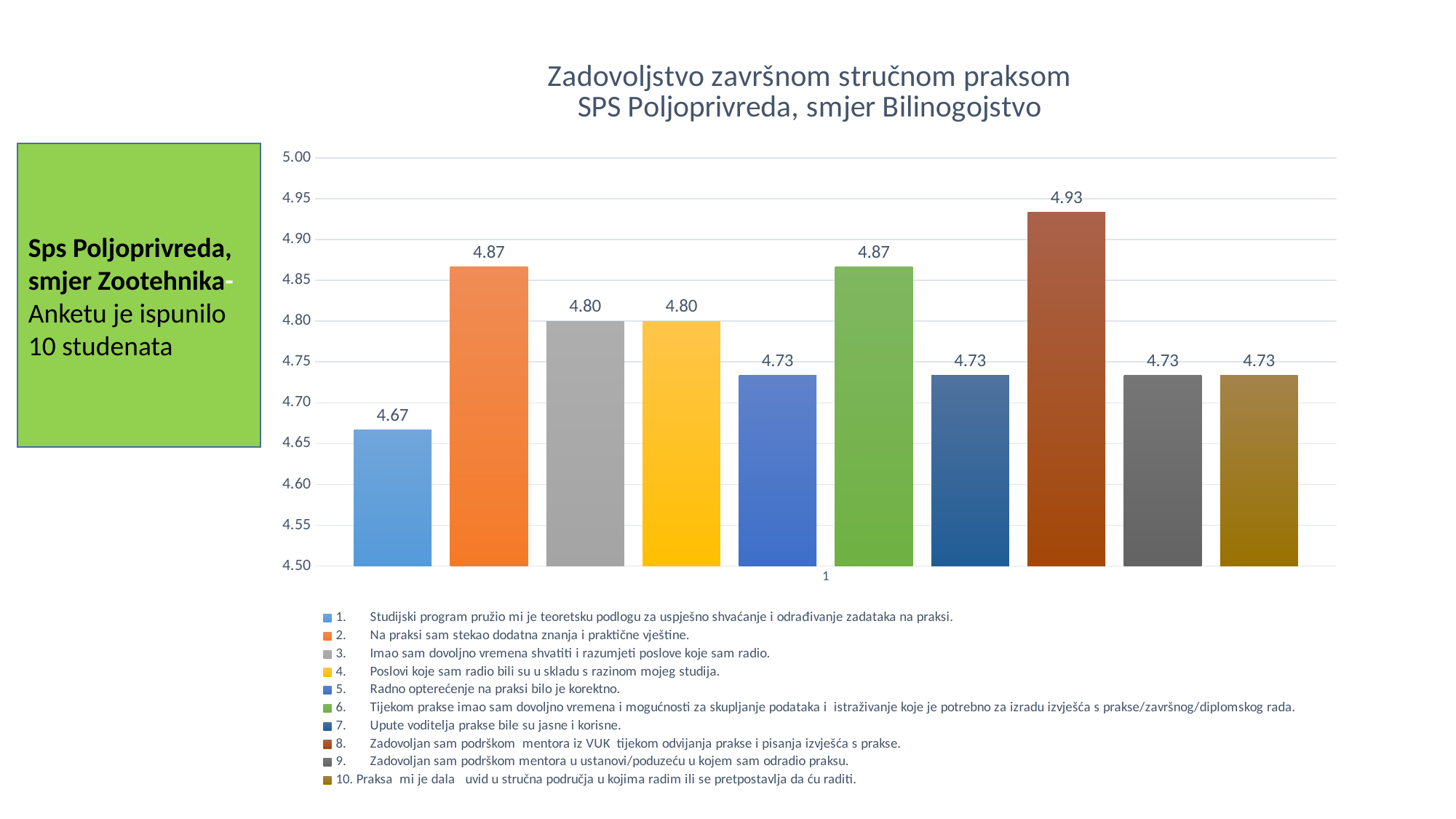
What is the value for series 1 (Studijski program pružio mi je teoretsku podlogu za uspješno shvaćanje i odrađivanje zadataka na praksi)? 4.67 What is the title of the chart? Zadovoljstvo završnom stručnom praksom SPS Poljoprivreda, smjer Bilinogojstvo What is the value for series 8 (Zadovoljan sam podrškom mentora iz VUK tijekom odvijanja prakse i pisanja izvješća s prakse)? 4.93 Which legend entry has the lowest value in the chart? 1. Studijski program pružio mi je teoretsku podlogu za uspješno shvaćanje i odrađivanje zadataka na praksi. How many bars are plotted in the chart? 10 What is the value for series 3 (Imao sam dovoljno vremena shvatiti i razumjeti poslove koje sam radio)? 4.80 Which legend entry has the highest value in the chart? 8. Zadovoljan sam podrškom mentora iz VUK tijekom odvijanja prakse i pisanja izvješća s prakse. What is the difference between the value for series 8 and the value for series 1? 0.26 What is the value for series 6 (Tijekom prakse imao sam dovoljno vremena i mogućnosti za skupljanje podataka i istraživanje...)? 4.87 What type of chart is shown on the slide? bar chart How many series does the legend list? 10 Which is larger: the value for series 2 (Na praksi sam stekao dodatna znanja i praktične vještine) or the value for series 5 (Radno opterećenje na praksi bilo je korektno)? series 2